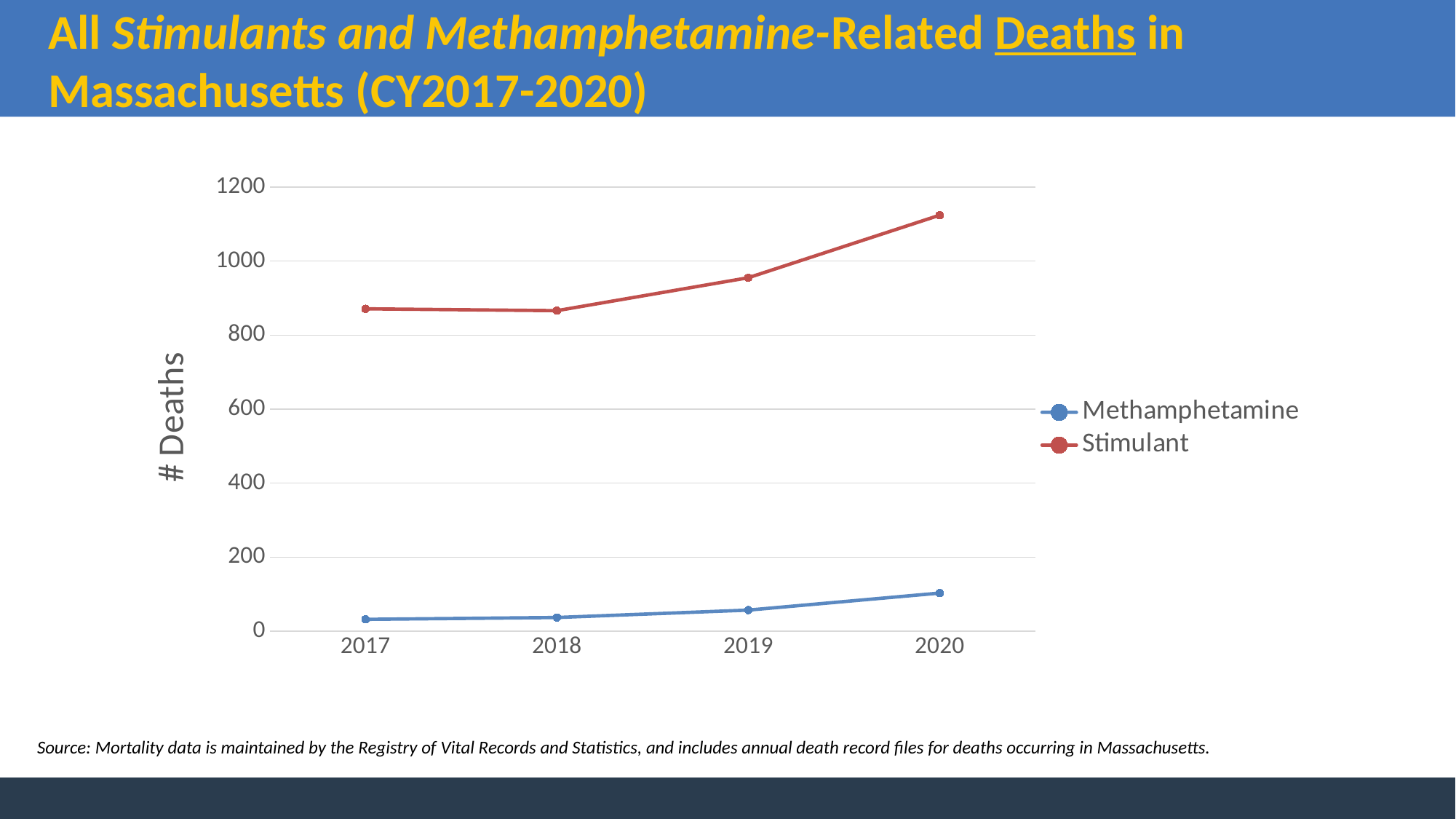
Is the Stimulant value for 2020 greater or less than 1000? greater Which series has the larger value in 2020, Stimulant or Methamphetamine? Stimulant How many series does the legend list? 2 What is the label on the vertical axis? # Deaths Does the Methamphetamine series rise or fall from 2017 to 2020? rise Is the Stimulant value for 2017 greater or less than 800? greater What kind of chart is shown on the slide? line chart In which year is the Stimulant series at its highest? 2020 In which year is the Methamphetamine series at its highest? 2020 Is the Methamphetamine value for 2020 greater or less than 200? less How many years are plotted along the x axis? 4